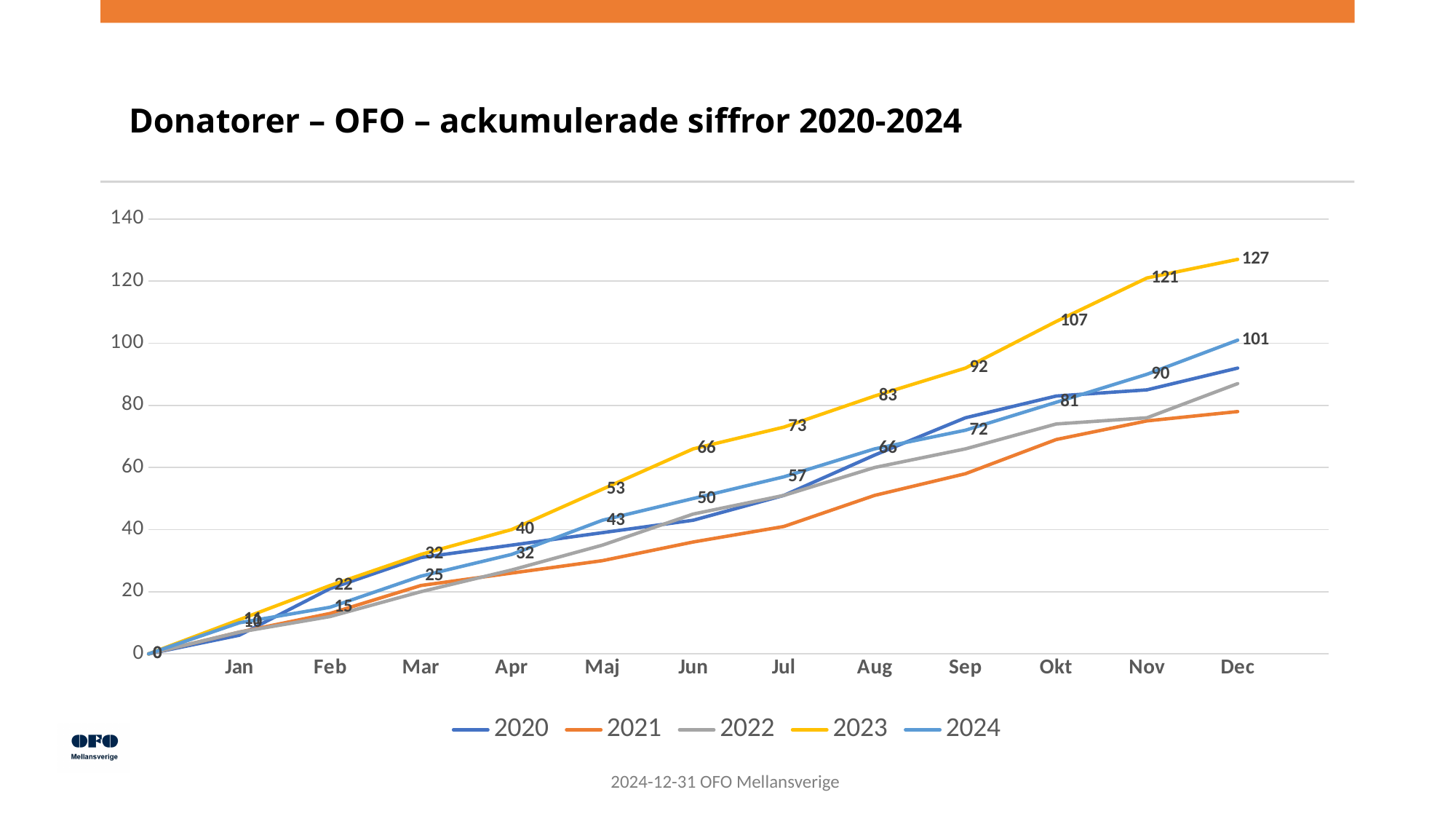
Do the values for 2023 rise or fall from Jan to Dec? rise Which series has the highest value in Dec? 2023 What kind of chart is shown on the slide? line chart Is the value for 2020 in Dec greater or less than 100? less What is the value for 2023 in Dec? 127 What is the value for 2024 in Jun? 50 How many series does the legend list? 5 What is the value for 2024 in Dec? 101 What is the difference between the 2023 and 2024 values in Dec? 26 Which series has the lowest value in Dec? 2021 What is the value for 2023 in Okt? 107 What is the title of the chart? Donatorer – OFO – ackumulerade siffror 2020-2024